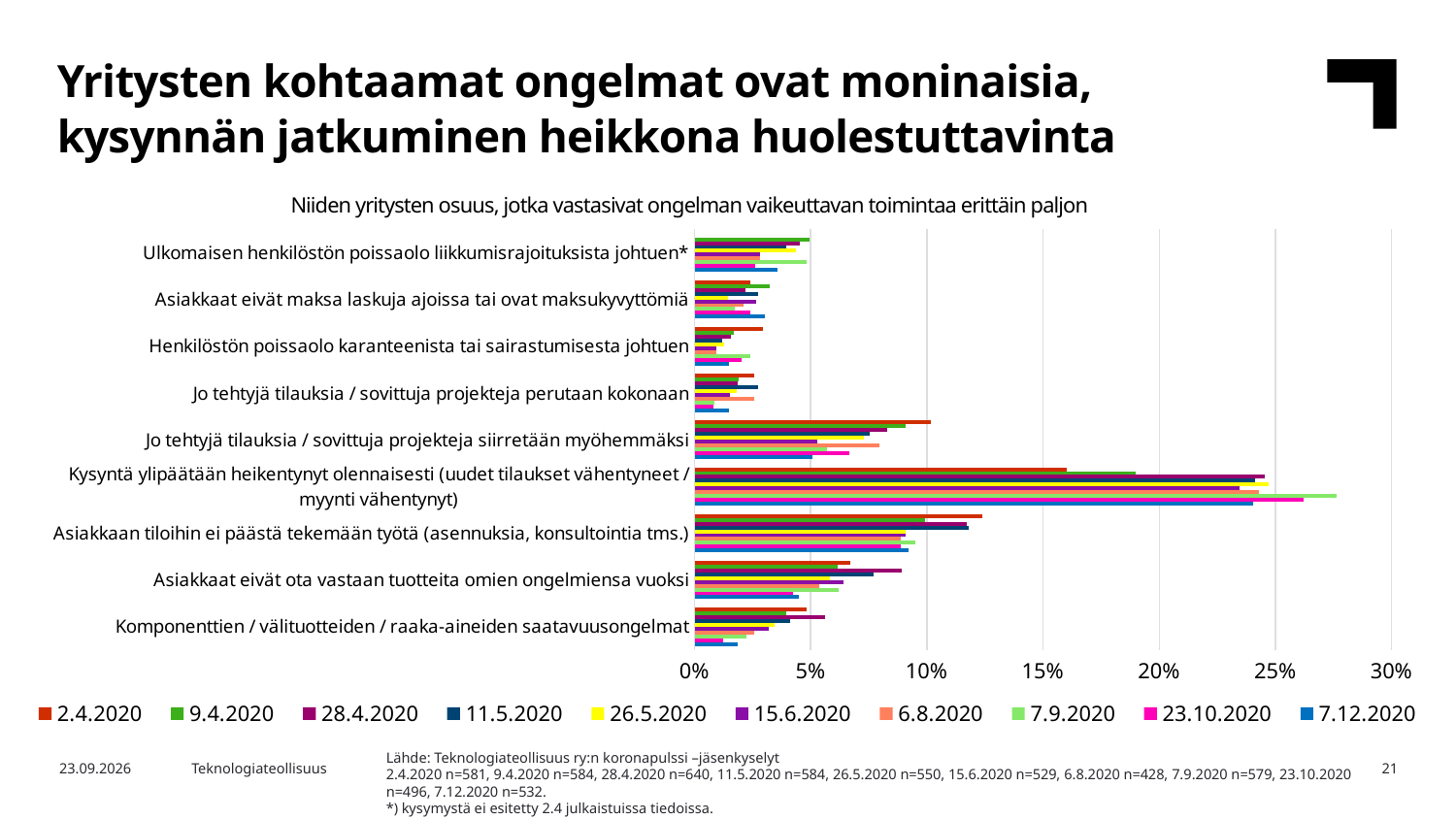
Is the 2.4.2020 value for 'Asiakkaan tiloihin ei päästä tekemään työtä' greater or less than 10%? greater What is the first survey date listed in the chart legend? 2.4.2020 For 'Kysyntä ylipäätään heikentynyt olennaisesti', which is larger: the 7.9.2020 value or the 2.4.2020 value? 7.9.2020 Is the 2.4.2020 value for 'Kysyntä ylipäätään heikentynyt olennaisesti' greater or less than 15%? greater How many survey dates (series) does the legend list? 10 Is the 7.12.2020 value for 'Komponenttien / välituotteiden / raaka-aineiden saatavuusongelmat' greater or less than 5%? less From 2.4.2020 to 7.9.2020, do the values for 'Kysyntä ylipäätään heikentynyt olennaisesti' generally rise or fall? rise How many problem categories are listed on the chart's vertical axis? 9 Which category has the highest values overall on the chart? Kysyntä ylipäätään heikentynyt olennaisesti (uudet tilaukset vähentyneet / myynti vähentynyt) What kind of chart is shown on the slide? bar chart For 'Asiakkaan tiloihin ei päästä tekemään työtä', which is larger: the 2.4.2020 value or the 7.12.2020 value? 2.4.2020